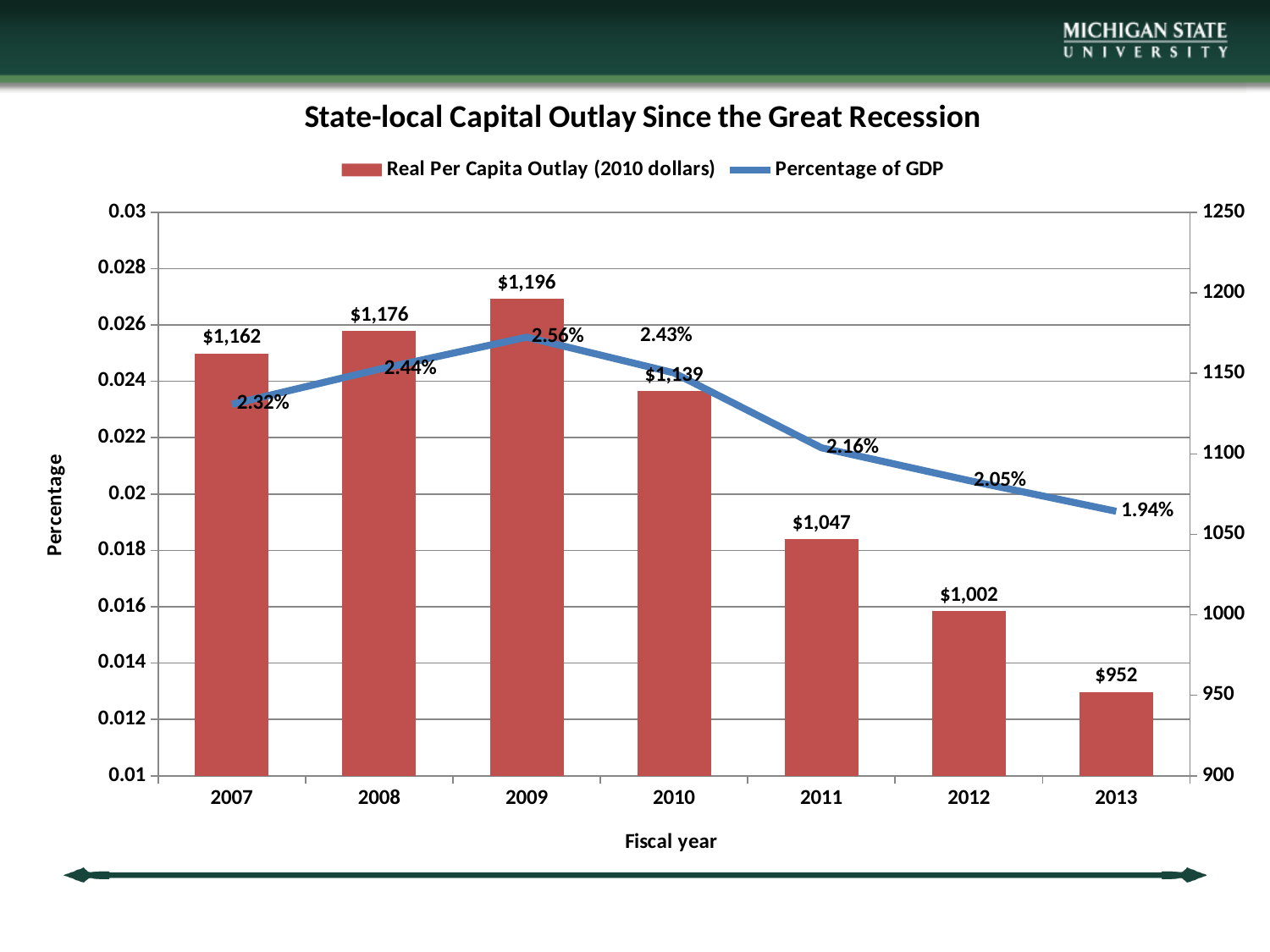
How does the Percentage of GDP change from 2009 to 2013? It falls What is the Percentage of GDP for fiscal year 2013? 1.94% How many series does the legend list? 2 What is the Real Per Capita Outlay (2010 dollars) for fiscal year 2011? $1,047 What is the title of the chart? State-local Capital Outlay Since the Great Recession Is the Real Per Capita Outlay for 2012 greater or less than 1050? less How many fiscal years are shown on the x axis? 7 What is the Real Per Capita Outlay (2010 dollars) for fiscal year 2009? $1,196 Which fiscal year has the lowest Real Per Capita Outlay (2010 dollars)? 2013 What is the difference in Real Per Capita Outlay (2010 dollars) between 2009 and 2013? $244 Which fiscal year has the highest Percentage of GDP? 2009 Which is larger, the Real Per Capita Outlay in 2008 or in 2010? 2008